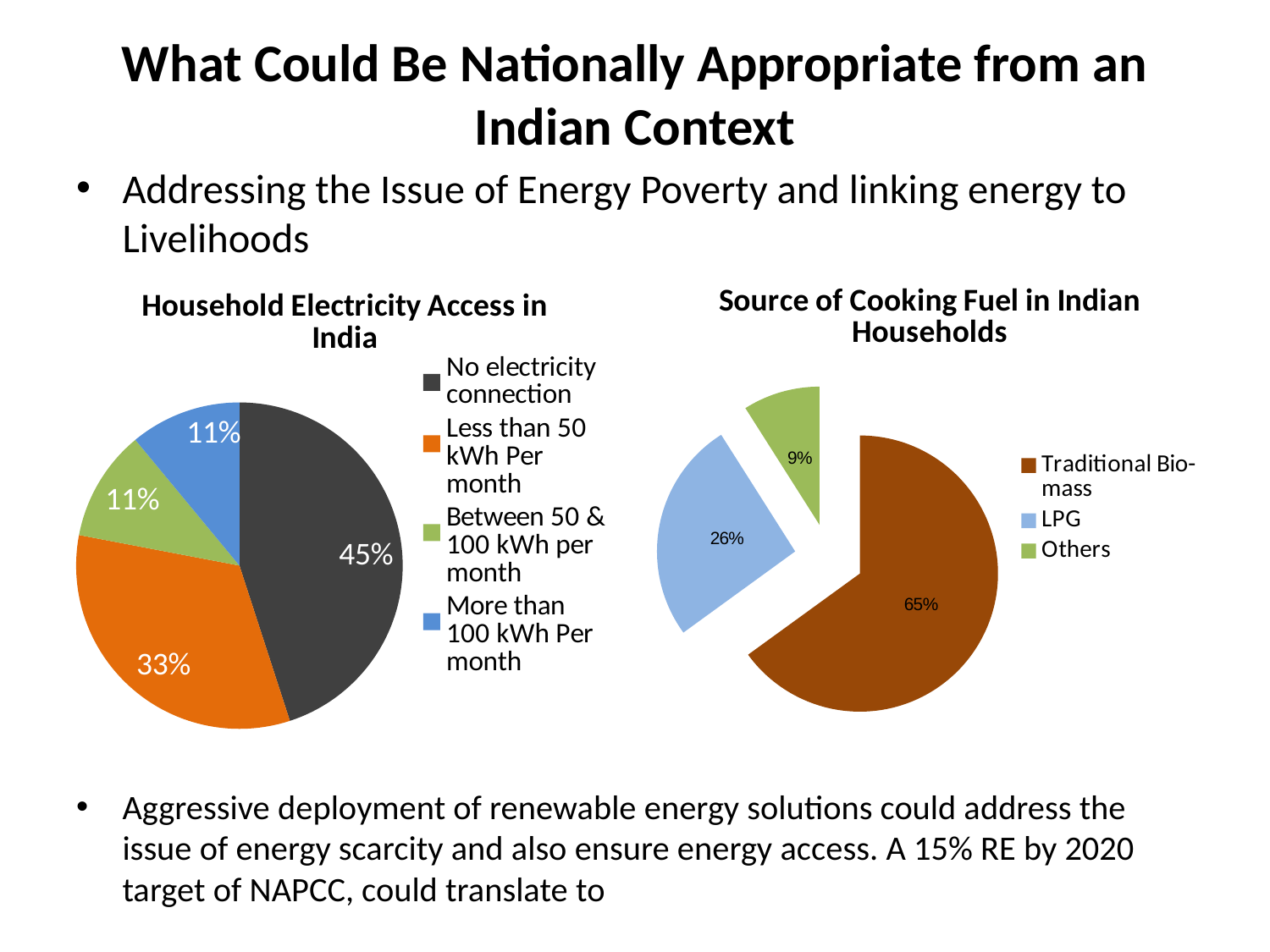
In the 'Household Electricity Access in India' chart, what is the difference between the 'No electricity connection' share and the 'Less than 50 kWh Per month' share? 12% In the 'Source of Cooking Fuel in Indian Households' chart, which category has the smallest share? Others In the 'Household Electricity Access in India' chart, what share of households have no electricity connection? 45% In the 'Source of Cooking Fuel in Indian Households' chart, what share is Traditional Biomass? 65% In the 'Household Electricity Access in India' chart, which category has the largest share? No electricity connection In the 'Source of Cooking Fuel in Indian Households' chart, what colour is the Traditional Biomass slice? Brown In the 'Source of Cooking Fuel in Indian Households' chart, what share is LPG? 26% In the 'Source of Cooking Fuel in Indian Households' chart, which is larger, LPG or Others? LPG In the 'Household Electricity Access in India' chart, what share of households use less than 50 kWh per month? 33% In the 'Source of Cooking Fuel in Indian Households' chart, what is the difference between the Traditional Biomass share and the LPG share? 39% In the 'Household Electricity Access in India' chart, how many categories does the legend list? 4 What type of chart is 'Household Electricity Access in India'? Pie chart